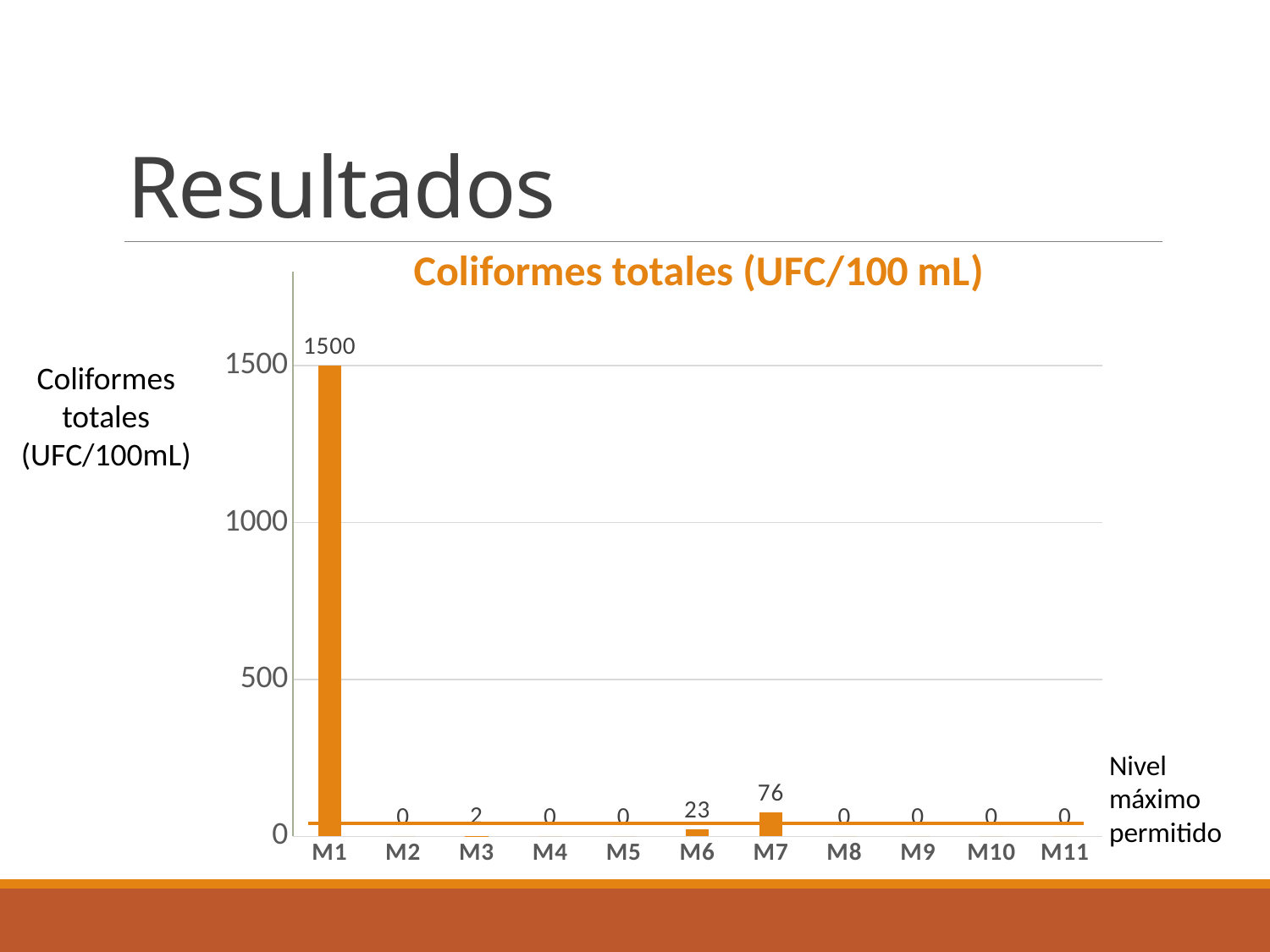
What kind of chart is shown on the slide? Bar chart How many samples are shown on the x axis of the chart? 11 Which has a larger value, M6 or M7? M7 What is the value for M6 in the Coliformes totales chart? 23 What is the value for M9 in the Coliformes totales chart? 0 Which sample has the highest value in the Coliformes totales chart? M1 What is the value for M3 in the Coliformes totales chart? 2 What is the difference between the values for M1 and M7? 1424 What is the difference between the values for M7 and M6? 53 What is the value for M1 in the Coliformes totales chart? 1500 What is the value for M7 in the Coliformes totales chart? 76 Is the value for M1 greater or less than 1000? greater